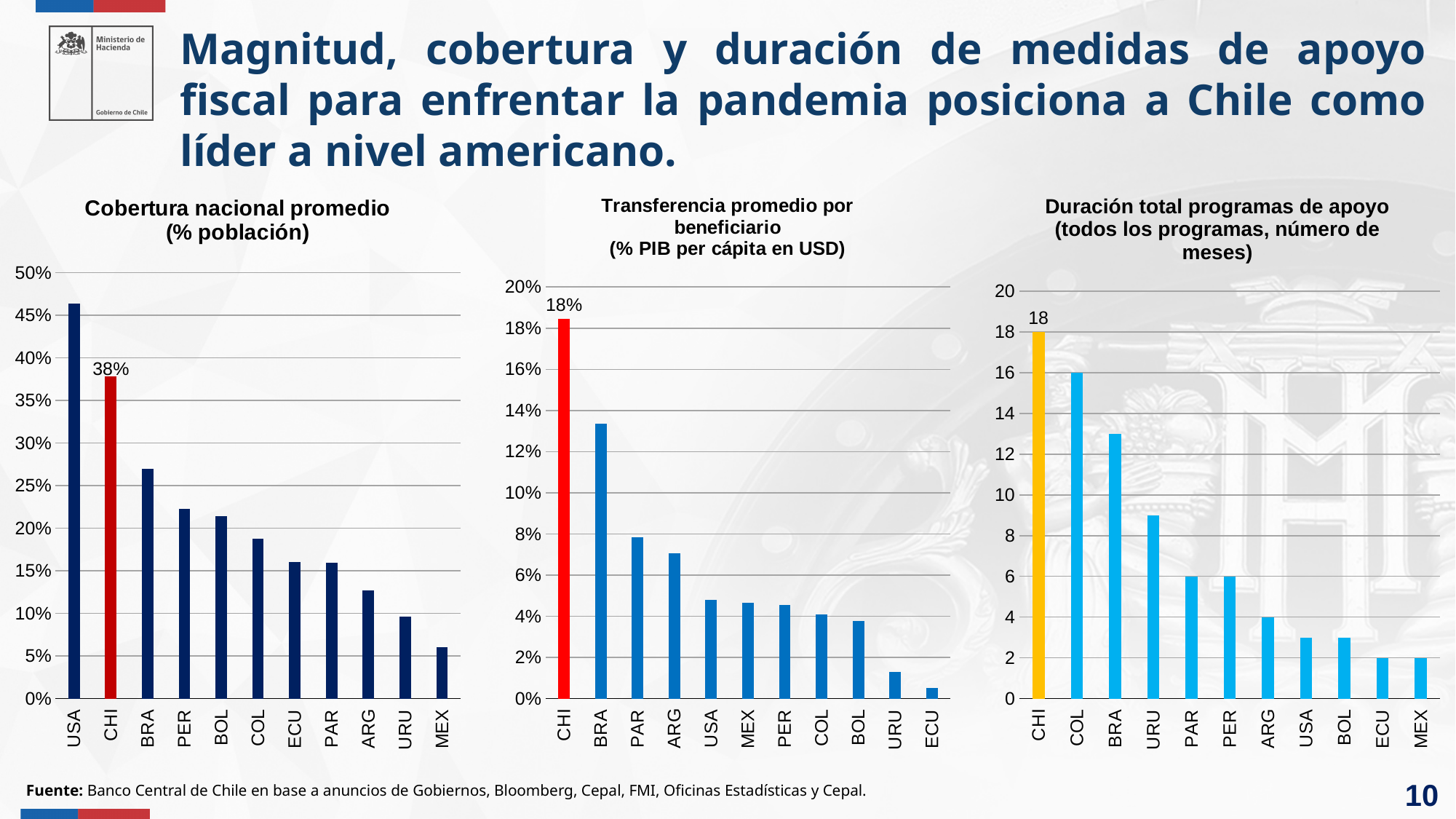
In the 'Cobertura nacional promedio (% población)' chart, is the value for BRA greater or less than 25%? greater What kind of chart is the 'Duración total programas de apoyo' chart? bar chart In the 'Transferencia promedio por beneficiario' chart, which country has the lowest value? ECU In the 'Duración total programas de apoyo' chart, which is larger, the value for BRA or the value for URU? BRA In the 'Duración total programas de apoyo' chart, what is the value for CHI? 18 In the 'Cobertura nacional promedio (% población)' chart, which country has the highest value? USA In the 'Cobertura nacional promedio (% población)' chart, which country has the lowest value? MEX In the 'Cobertura nacional promedio (% población)' chart, what is the value for CHI? 38% In the 'Transferencia promedio por beneficiario' chart, what is the value for CHI? 18% In the 'Duración total programas de apoyo' chart, what is the value for COL? 16 In the 'Transferencia promedio por beneficiario' chart, is the value for BRA greater or less than 12%? greater How many countries are shown in the 'Cobertura nacional promedio (% población)' chart? 11